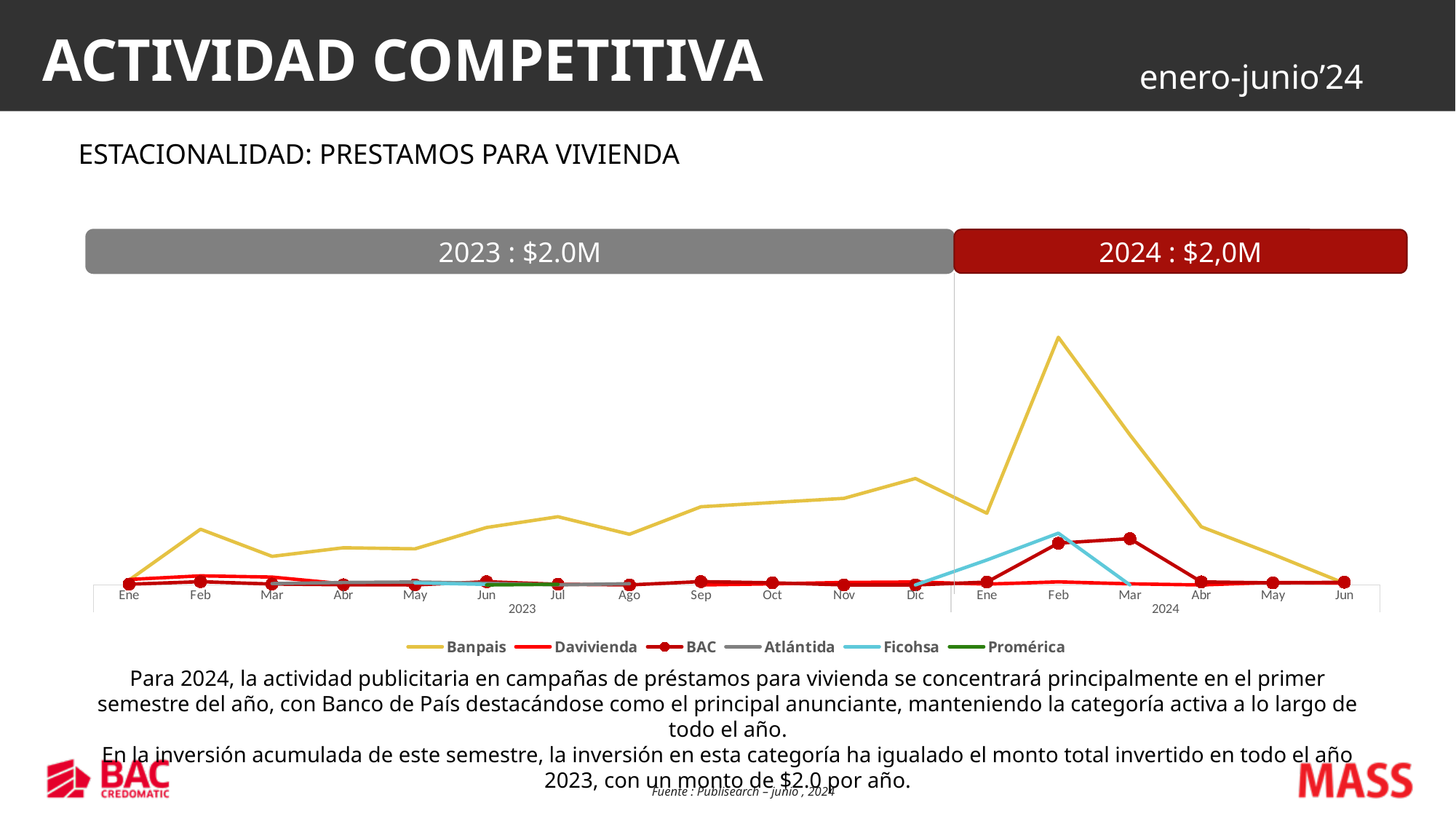
Which series reaches the highest point on the chart? Banpais What is the subtitle of the chart on the slide? ESTACIONALIDAD: PRESTAMOS PARA VIVIENDA Does the Banpais line rise or fall from Ago 2023 to Dic 2023? Rise Does the Banpais line rise or fall from Feb 2024 to Jun 2024? Fall What total is shown in the banner for 2024? $2,0M In which month does the Banpais line reach its peak? Feb 2024 Which series is drawn in yellow? Banpais How many monthly points are plotted along the x axis? 18 What total is shown in the banner for 2023? $2.0M What kind of chart is shown on the slide? Line chart How many series does the legend list? 6 In Feb 2024, which is higher, Banpais or BAC? Banpais